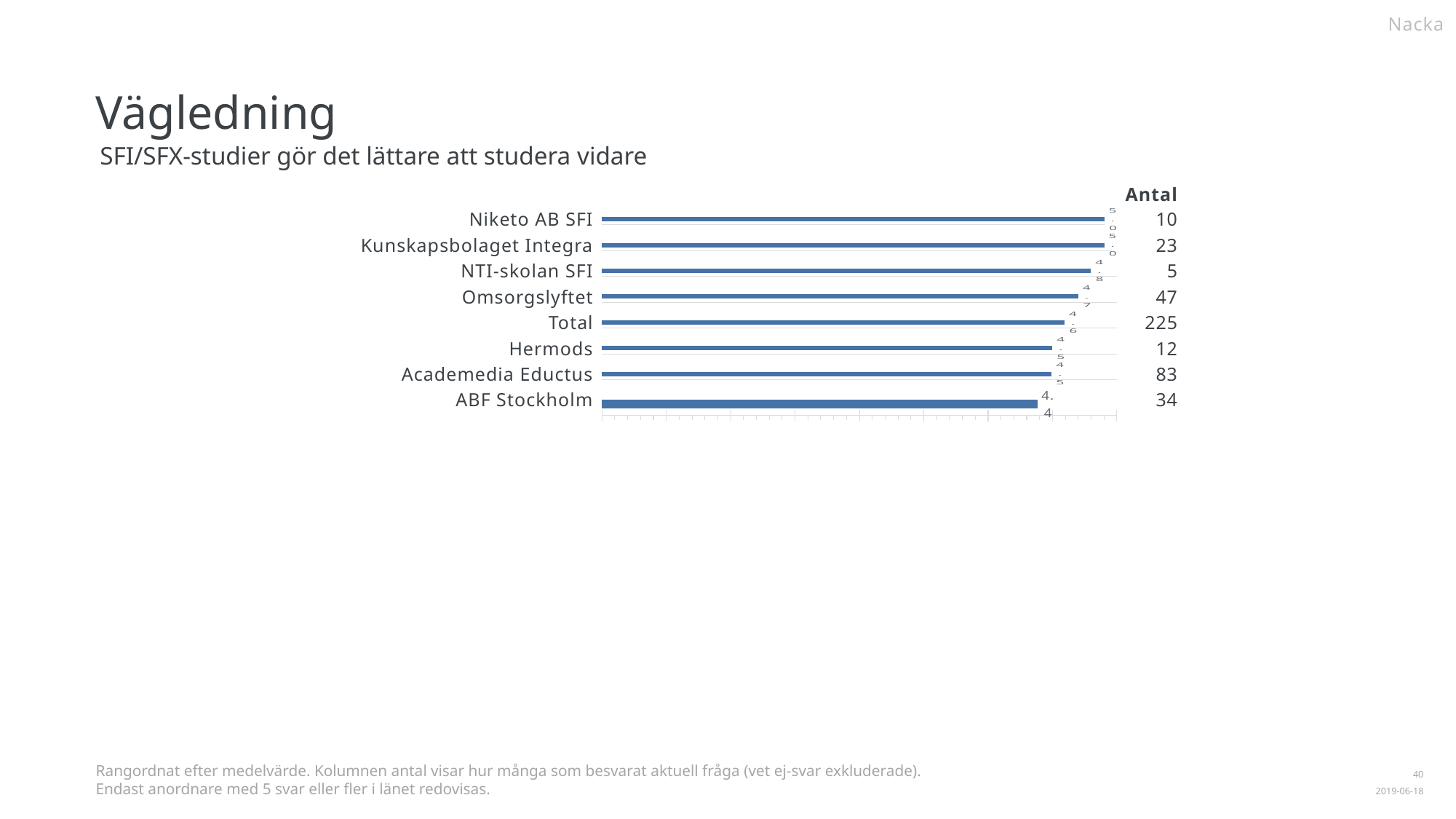
According to the Antal column, how many respondents answered for Total? 225 What kind of chart is shown on the slide? bar chart How many categories (bars) does the chart show? 8 What is the value for Total? 4.6 What is the value for ABF Stockholm? 4.4 What is the value for Niketo AB SFI? 5.0 Which category has the lowest value in the chart? ABF Stockholm What is the subtitle (question text) shown above the chart? SFI/SFX-studier gör det lättare att studera vidare Which is larger, the value for Niketo AB SFI or the value for ABF Stockholm? Niketo AB SFI Which is larger, the value for NTI-skolan SFI or the value for Hermods? NTI-skolan SFI Do the bar values rise or fall going from the top category to the bottom category? fall What is the difference between the value for Niketo AB SFI and the value for ABF Stockholm? 0.6